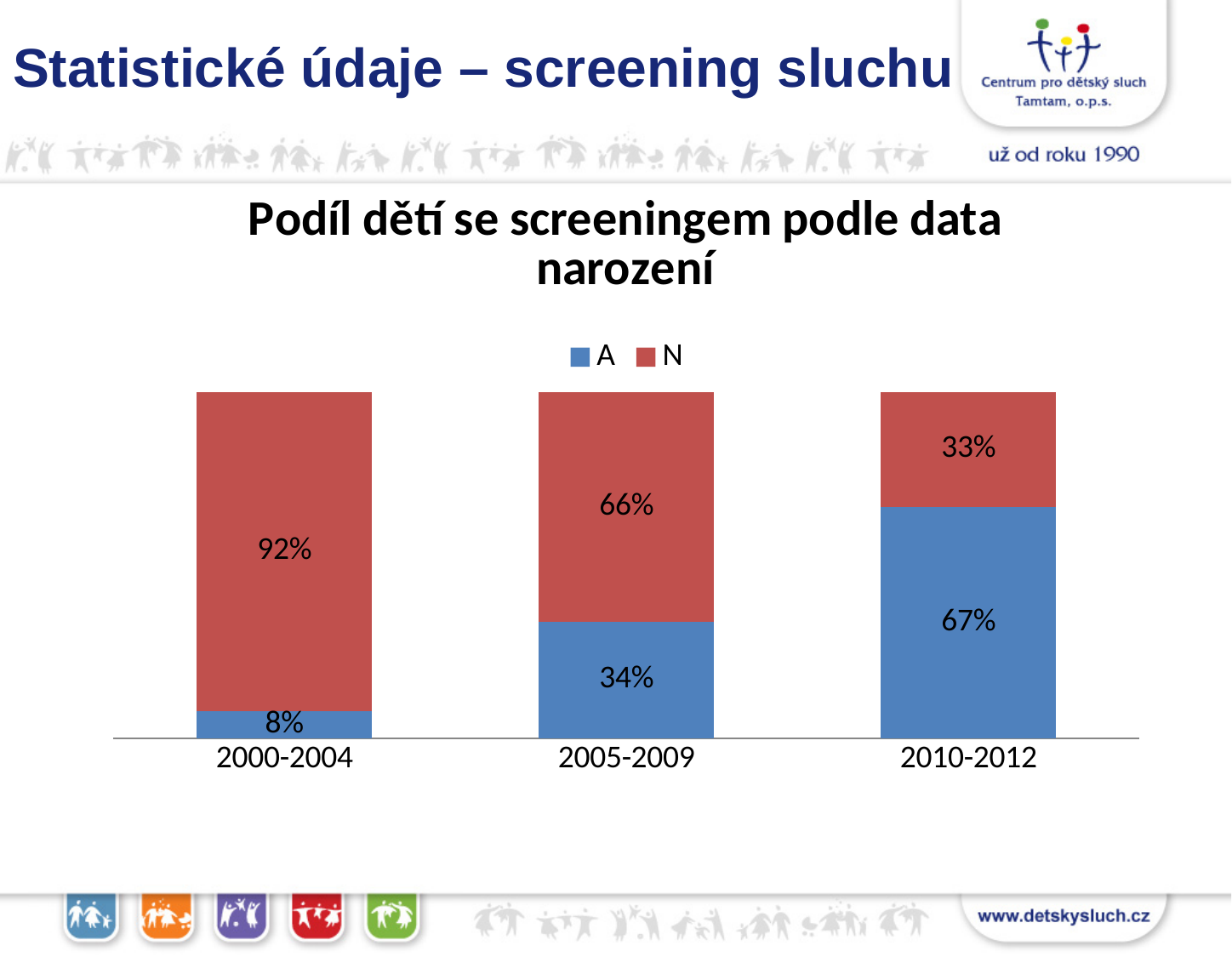
How many categories are shown on the x axis? 3 How many series does the legend list? 2 What is the value for series A in the 2010-2012 category? 67% What is the difference between the series A values for 2010-2012 and 2005-2009? 33% What kind of chart is shown on the slide? Stacked bar chart Which category has the lowest value for series N? 2010-2012 What is the value for series N in the 2005-2009 category? 66% Do the values for series A rise or fall from 2000-2004 to 2010-2012? Rise What is the value for series N in the 2000-2004 category? 92% Which is larger in the 2005-2009 category, series A or series N? N Which category has the highest value for series A? 2010-2012 What is the value for series A in the 2000-2004 category? 8%